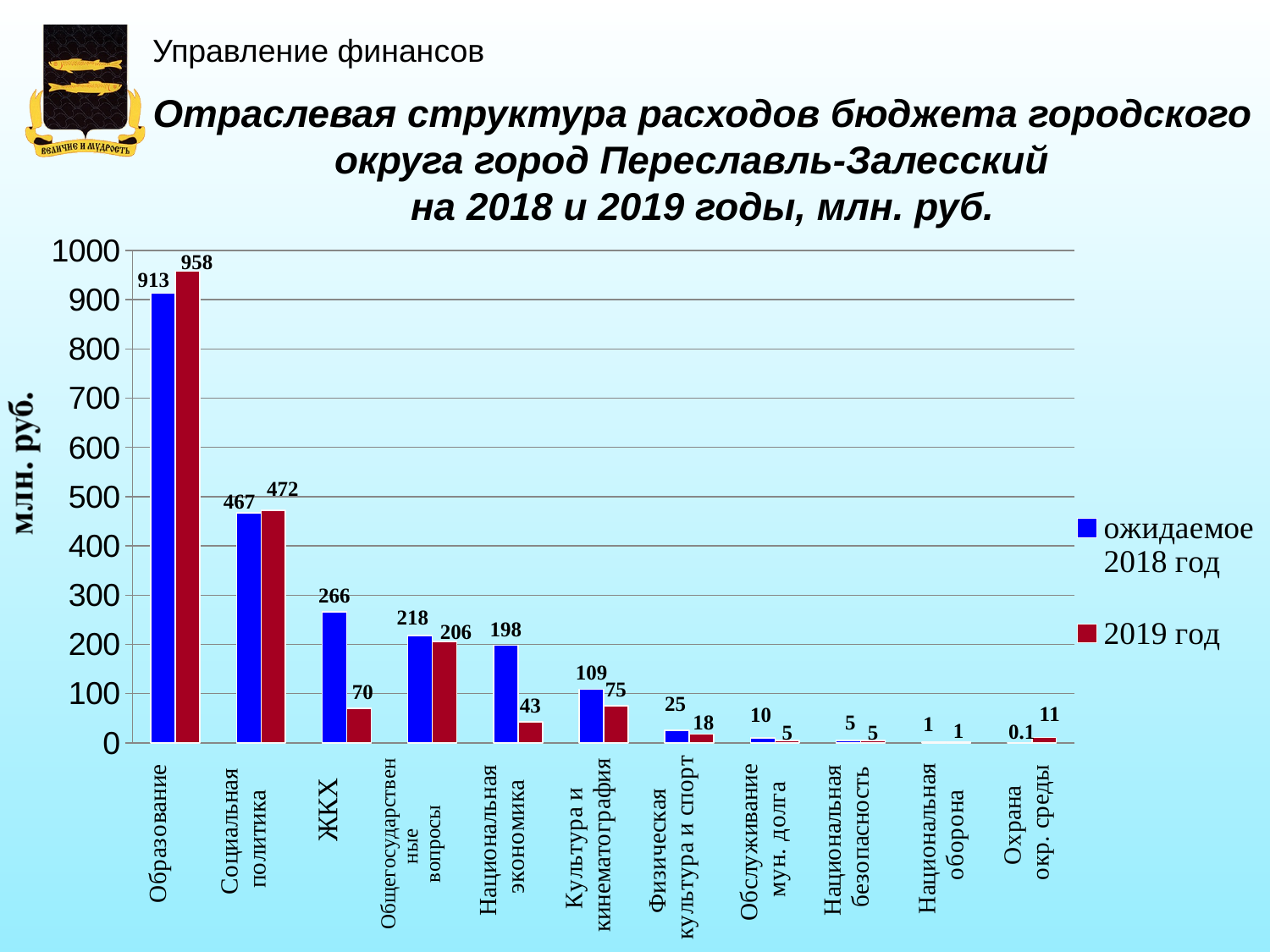
Which category has the lowest value in the ожидаемое 2018 год series? Охрана окр. среды What is the difference between the 2019 год and ожидаемое 2018 год values for Образование? 45 How many categories are shown on the x axis? 11 Which is larger for Общегосударственные вопросы: the ожидаемое 2018 год value or the 2019 год value? ожидаемое 2018 год Which category has the highest value in the 2019 год series? Образование What is the value for Образование in the ожидаемое 2018 год series? 913 What is the difference between the ожидаемое 2018 год and 2019 год values for Национальная экономика? 155 What is the value for ЖКХ in the 2019 год series? 70 How many series does the legend list? 2 What kind of chart is shown on the slide? bar chart What is the label of the y axis? млн. руб. What is the value for Охрана окр. среды in the ожидаемое 2018 год series? 0.1